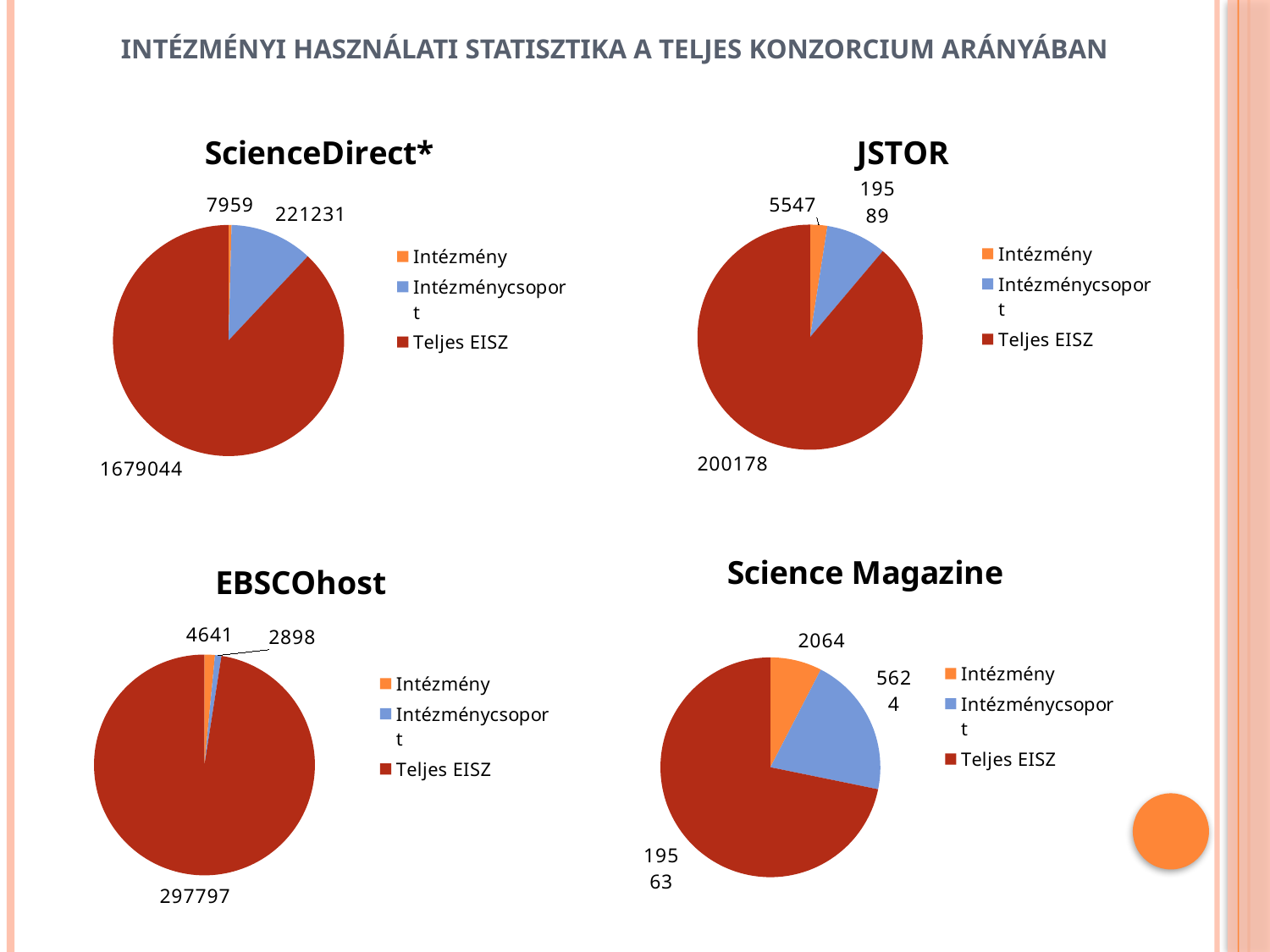
What kind of chart is the ScienceDirect* chart? pie chart In the Science Magazine chart, what is the value for Intézmény? 2064 In the JSTOR chart, what is the value for Intézmény? 5547 How many slices does the Science Magazine pie chart have? 3 In the ScienceDirect* chart, what is the value for Intézménycsoport? 221231 In the ScienceDirect* chart, what is the value for Teljes EISZ? 1679044 In the EBSCOhost chart, what is the value for Teljes EISZ? 297797 In the EBSCOhost chart, which category has the smallest slice? Intézménycsoport In the EBSCOhost chart, which is larger, Intézmény or Intézménycsoport? Intézmény In the ScienceDirect* chart, what is the difference between the Intézménycsoport value and the Intézmény value? 213272 How many entries does the legend of the JSTOR chart list? 3 In the JSTOR chart, which category has the largest slice? Teljes EISZ